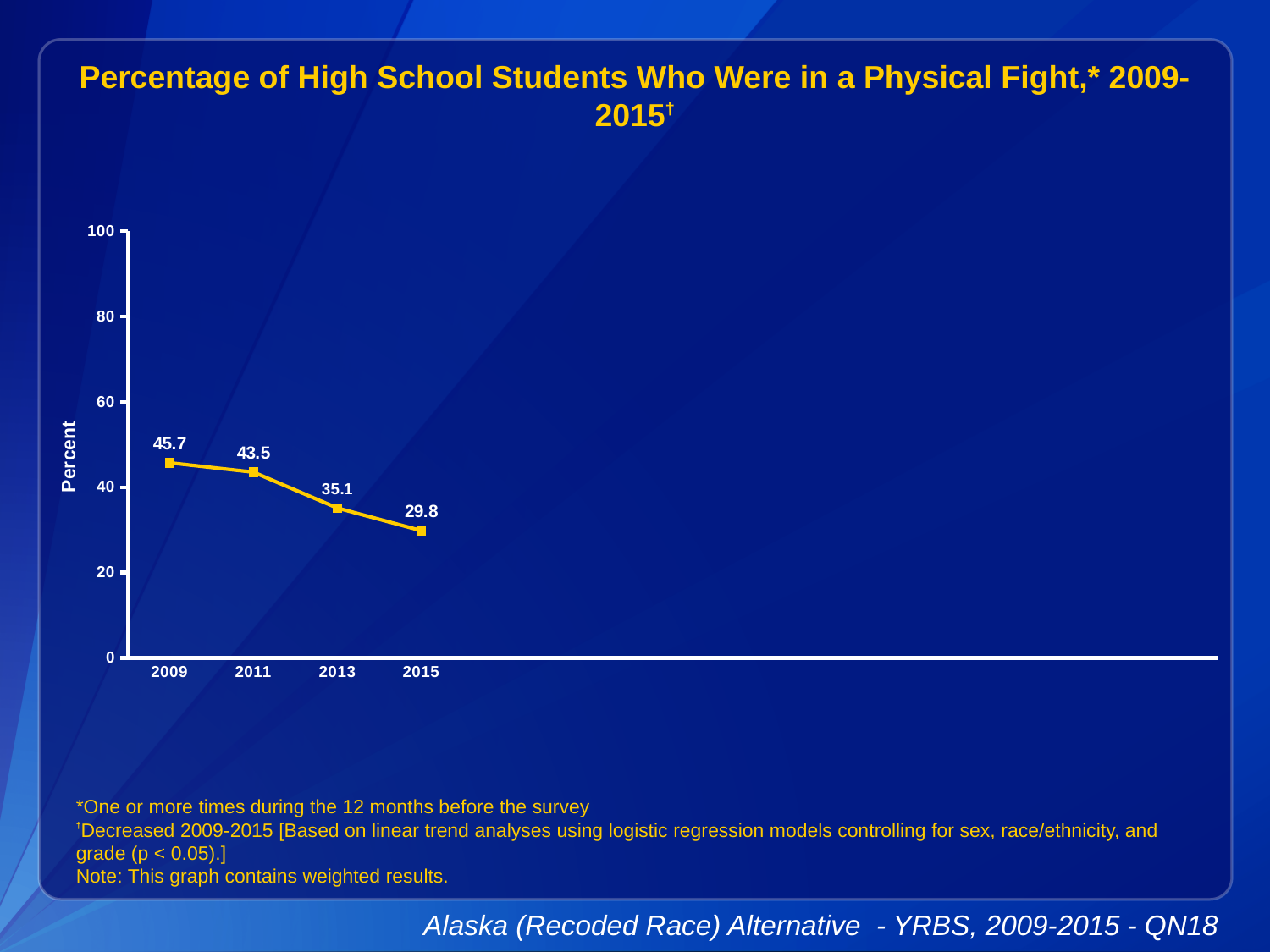
What is the value for 2009? 45.7 What is the value for 2011? 43.5 Do the values rise or fall from 2009 to 2015? fall What kind of chart is shown? line chart Which year has the highest value? 2009 What is the difference between the values for 2009 and 2015? 15.9 Is the value for 2013 greater or less than 40? less How many years are plotted on the chart? 4 What is the value for 2015? 29.8 Which is larger, the value for 2011 or the value for 2013? 2011 Which year has the lowest value? 2015 What is the value for 2013? 35.1